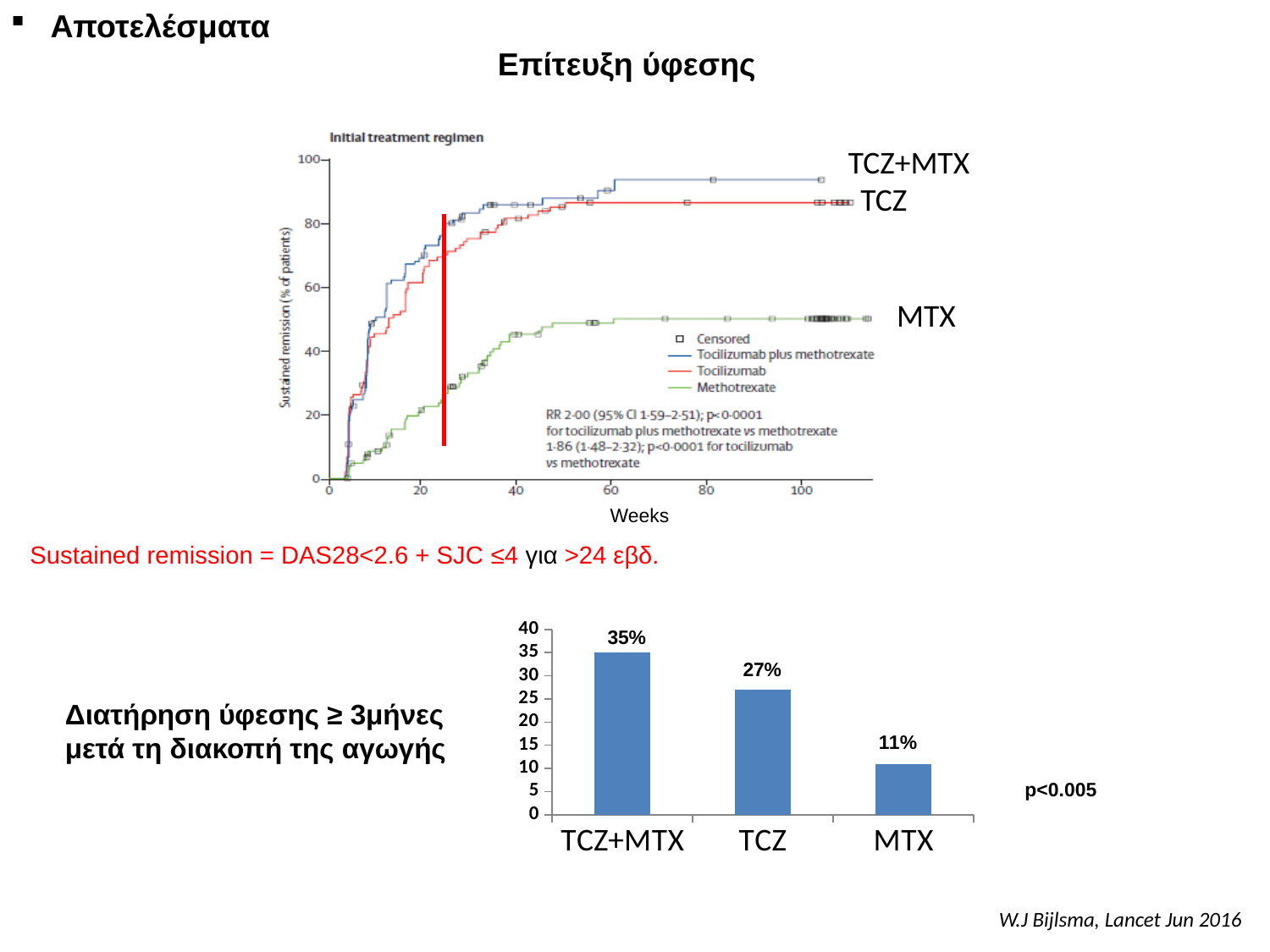
In the bottom bar chart, which category has the lowest value? MTX In the bottom bar chart, which category has the highest value? TCZ+MTX In the bottom bar chart, which is larger, the value for TCZ or the value for MTX? TCZ What kind of chart is the bottom chart on the slide? bar chart In the bottom bar chart, what is the value for TCZ+MTX? 35% In the bottom bar chart, what is the value for TCZ? 27% In the bottom bar chart, what is the value for MTX? 11% In the top chart (Initial treatment regimen), what kind of chart is it? line chart In the top chart (Initial treatment regimen), is the value for Methotrexate at week 100 greater or less than 60? less In the top chart (Initial treatment regimen), do the curves rise or fall as weeks increase? rise In the bottom bar chart, what is the difference between the values for TCZ+MTX and MTX? 24% In the bottom bar chart, how many categories are shown? 3